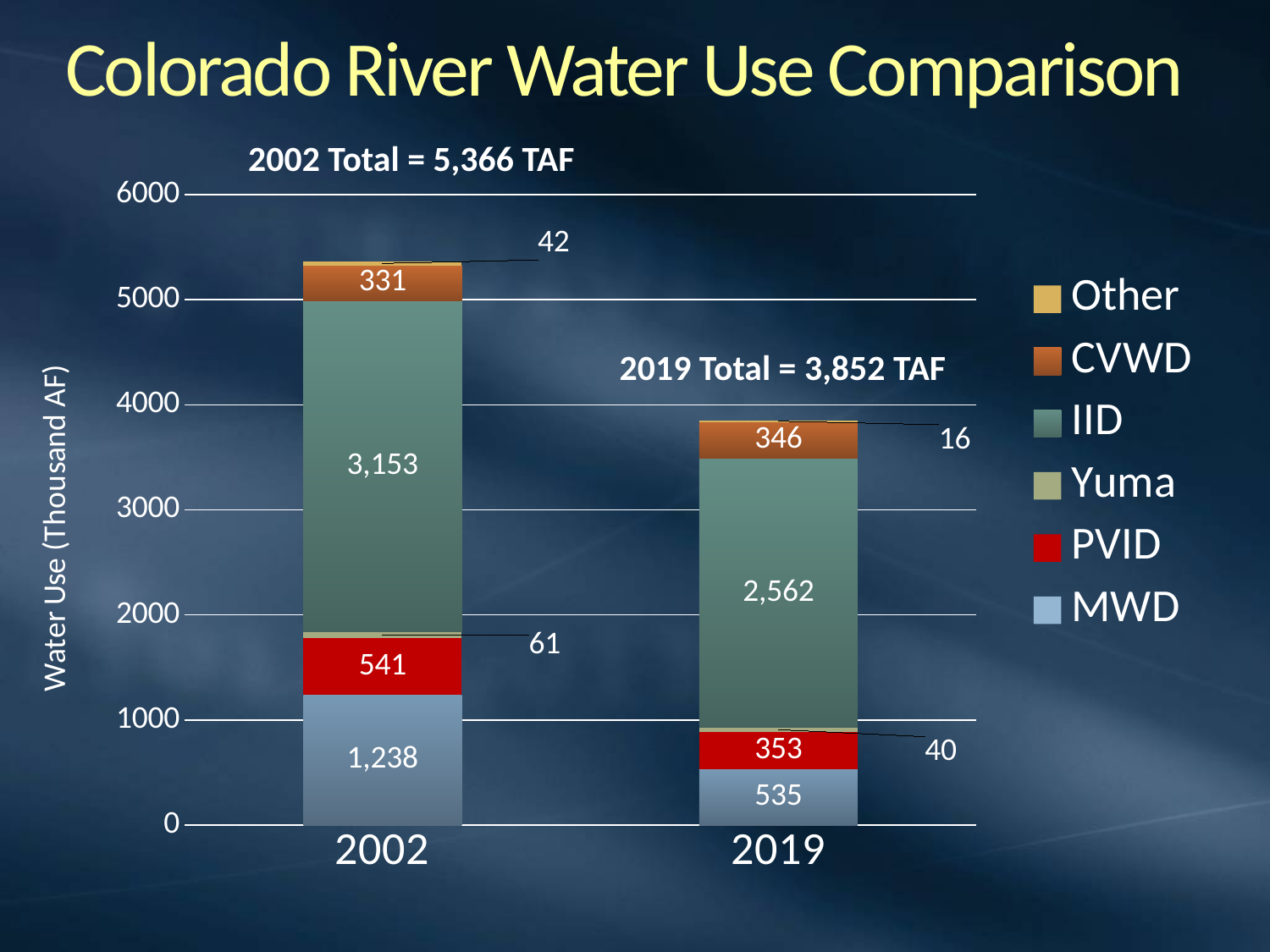
How many series does the legend list? 6 What kind of chart is shown on the slide? Stacked bar chart What is the total of the 2019 stacked bar? 3,852 TAF Which year has the larger PVID value, 2002 or 2019? 2002 What is the Yuma value for 2002? 61 What is the CVWD value for 2019? 346 Which series has the smallest value in the 2002 bar? Other What is the difference between the MWD values for 2002 and 2019? 703 What is the IID value for 2002? 3,153 What is the MWD value for 2019? 535 What is the total of the 2002 stacked bar? 5,366 TAF Which series has the largest value in the 2019 bar? IID